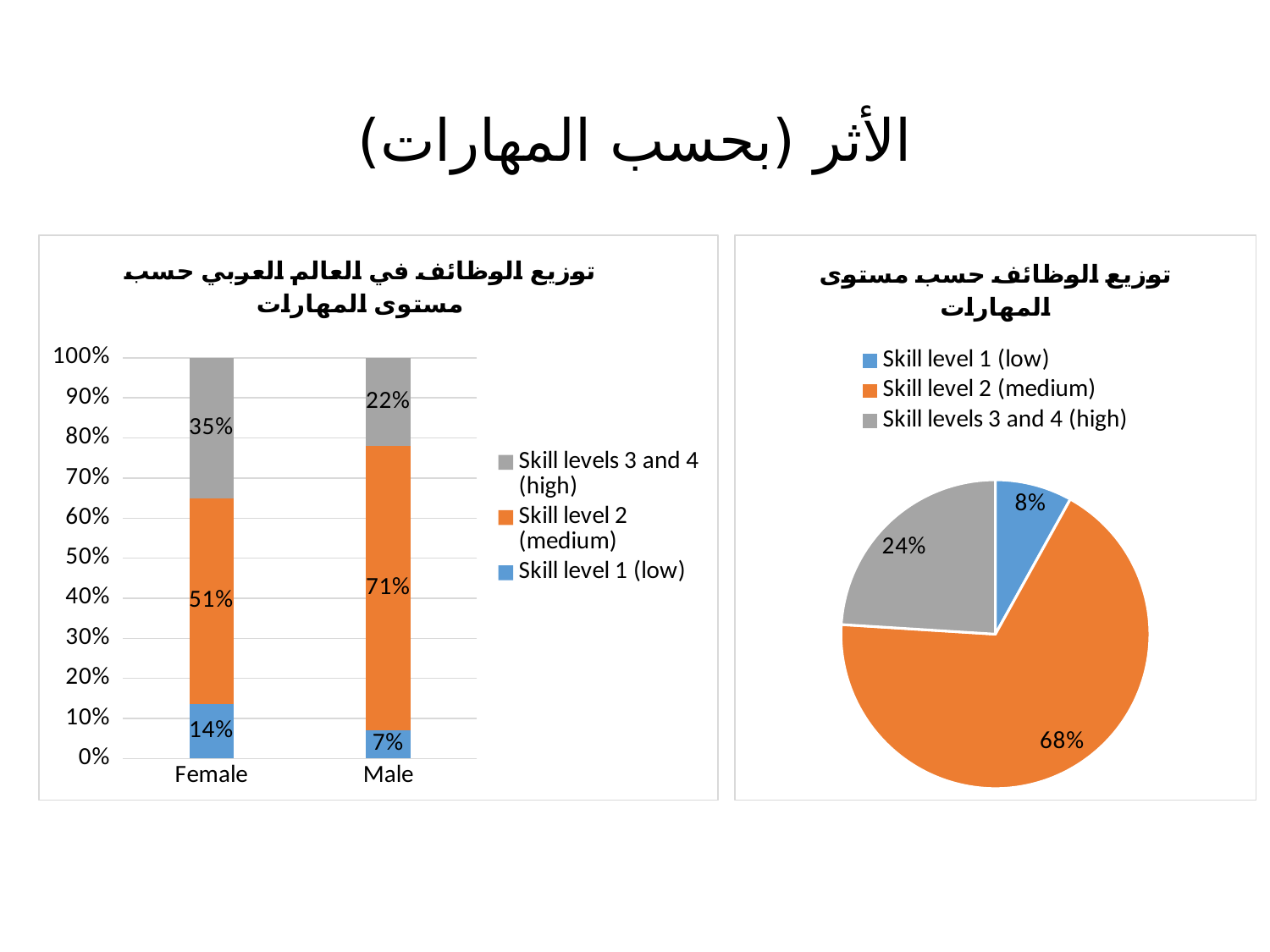
In the right pie chart, what share does Skill level 1 (low) have? 8% In the left stacked bar chart, what is the value for Skill level 2 (medium) for Female? 51% In the left stacked bar chart, how many categories are shown on the x axis? 2 In the left stacked bar chart, what is the value for Skill levels 3 and 4 (high) for Female? 35% What kind of chart is the chart on the left of the slide? Stacked bar chart In the right pie chart, which skill level has the smallest slice? Skill level 1 (low) In the right pie chart, what share does Skill level 2 (medium) have? 68% In the right pie chart, what colour is the slice for Skill levels 3 and 4 (high)? Grey In the left stacked bar chart, what is the difference between the Skill level 2 (medium) values for Male and Female? 20% In the left stacked bar chart, how many series does the legend list? 3 In the left stacked bar chart, which category has the larger Skill levels 3 and 4 (high) share, Female or Male? Female In the left stacked bar chart, what is the value for Skill level 1 (low) for Male? 7%